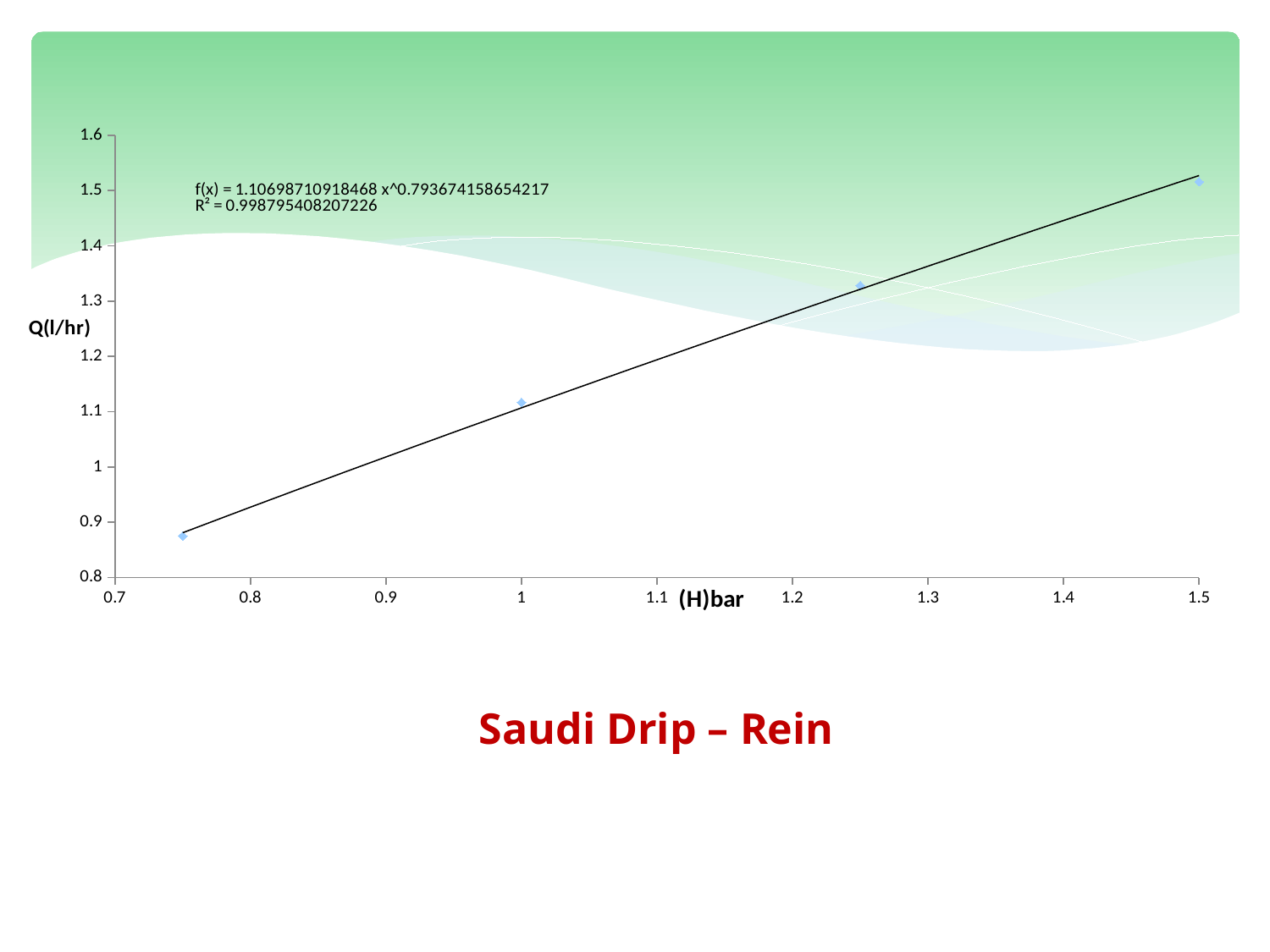
Is the Q value at H = 1.25 greater or less than 1.2? greater Is the Q value at H = 0.75 greater or less than 0.9? less Which has the larger Q value: the point at H = 1 or the point at H = 1.25? H = 1.25 Is the Q value at H = 1 greater or less than 1? greater Do the plotted Q values rise or fall as H increases along the x axis? rise At which H value is the plotted Q highest? 1.5 What is the R² value printed on the chart? 0.998795408207226 What is the label of the y axis? Q(l/hr) How many data points are plotted on the chart? 4 What kind of chart is shown on the slide? scatter chart